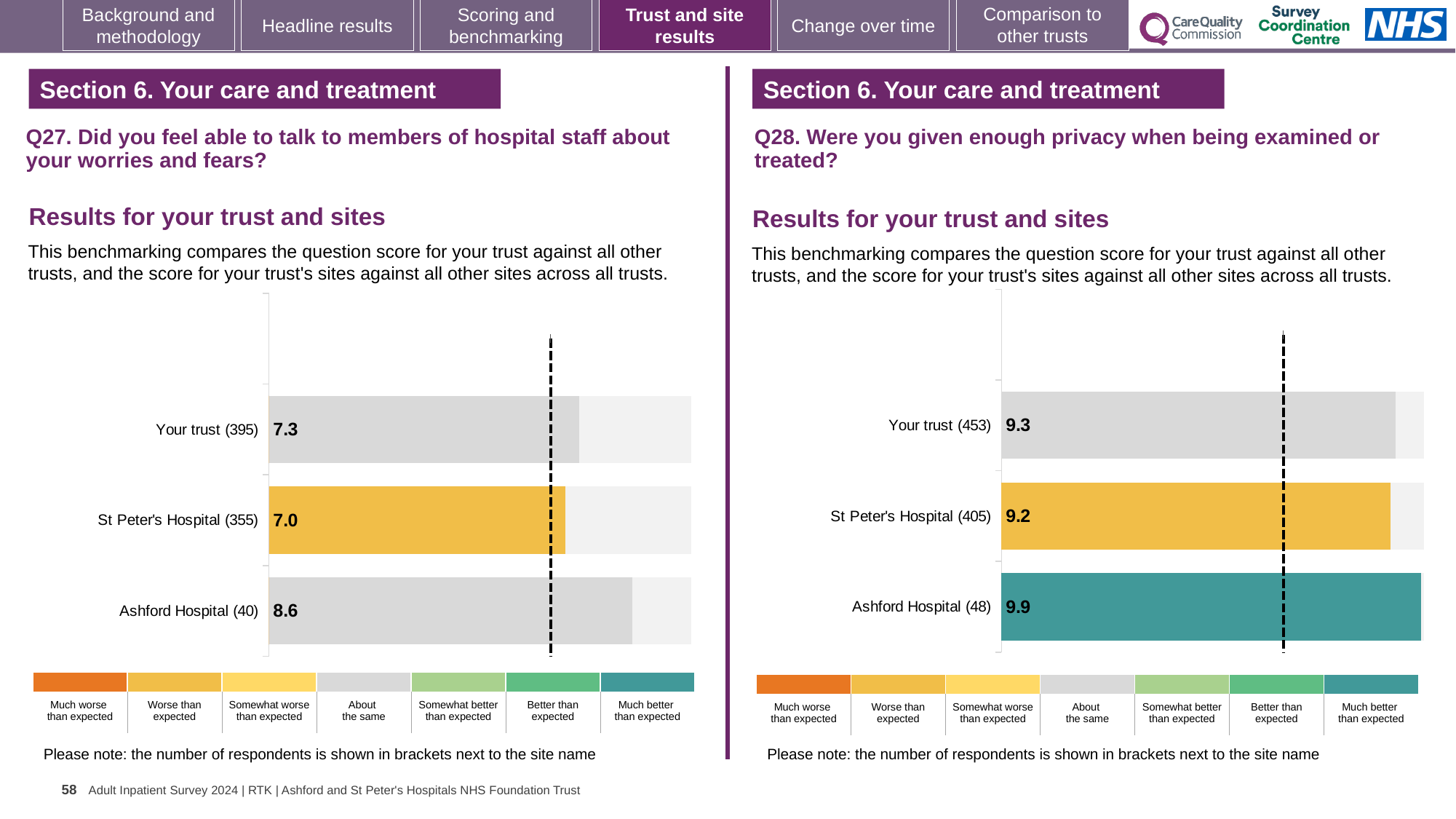
In the Q27 chart on the left, what is the score for Your trust? 7.3 In the Q28 chart on the right, what is the score for Ashford Hospital? 9.9 How many bars are plotted in the Q27 chart on the left? 3 In the Q27 chart on the left, how many respondents are shown in brackets for Ashford Hospital? 40 In the Q27 chart on the left, what is the score for St Peter's Hospital? 7.0 In the Q28 chart on the right, what is the difference between the scores for Ashford Hospital and Your trust? 0.6 In the Q28 chart on the right, how many respondents are shown in brackets for Your trust? 453 In the Q27 chart on the left, which site or trust has the highest score? Ashford Hospital In the Q27 chart on the left, what is the difference between the scores for Ashford Hospital and St Peter's Hospital? 1.6 In the Q28 chart on the right, which site or trust has the lowest score? St Peter's Hospital What kind of chart is used for the Q28 results on the right? bar chart In the Q28 chart on the right, is the score for Your trust larger or smaller than the score for St Peter's Hospital? larger